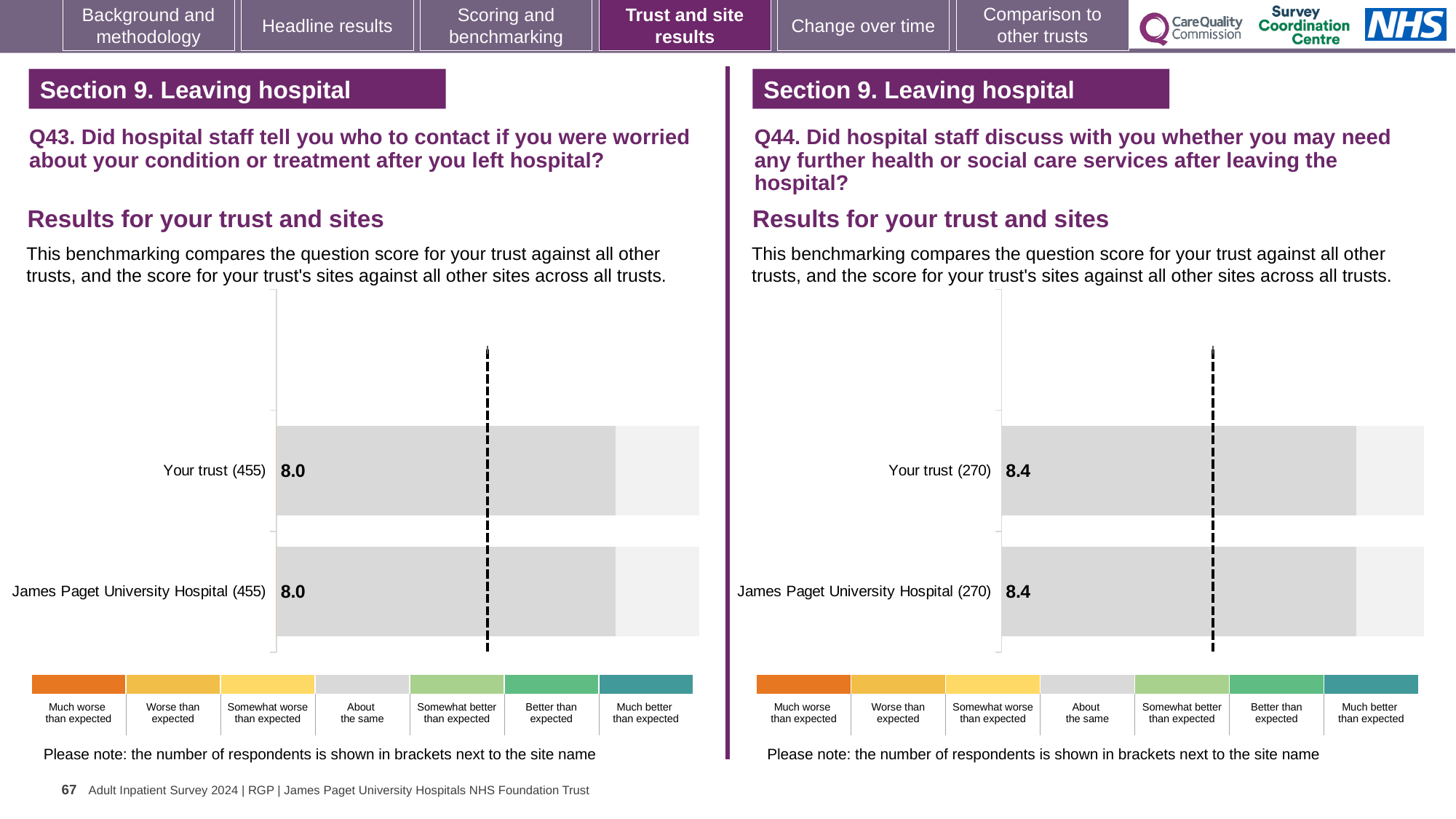
On the Q44 chart (right), how many respondents are shown in brackets next to James Paget University Hospital? 270 On the Q43 chart (left), what is the score for Your trust? 8.0 On the Q43 chart (left), what is the difference between the score for Your trust and the score for James Paget University Hospital? 0.0 On the Q44 chart (right), what is the difference between the score for Your trust and the score for James Paget University Hospital? 0.0 On the Q44 chart (right), what is the score for Your trust? 8.4 On the Q43 chart (left), how many respondents are shown in brackets next to Your trust? 455 Is the score for Your trust on the Q44 chart (right) larger than the score for Your trust on the Q43 chart (left)? Yes On the Q43 chart (left), what is the score for James Paget University Hospital? 8.0 On the Q44 chart (right), what is the score for James Paget University Hospital? 8.4 How many bars are plotted on the Q44 chart (right)? 2 What kind of chart is the Q43 chart (left)? Bar chart How many bars are plotted on the Q43 chart (left)? 2